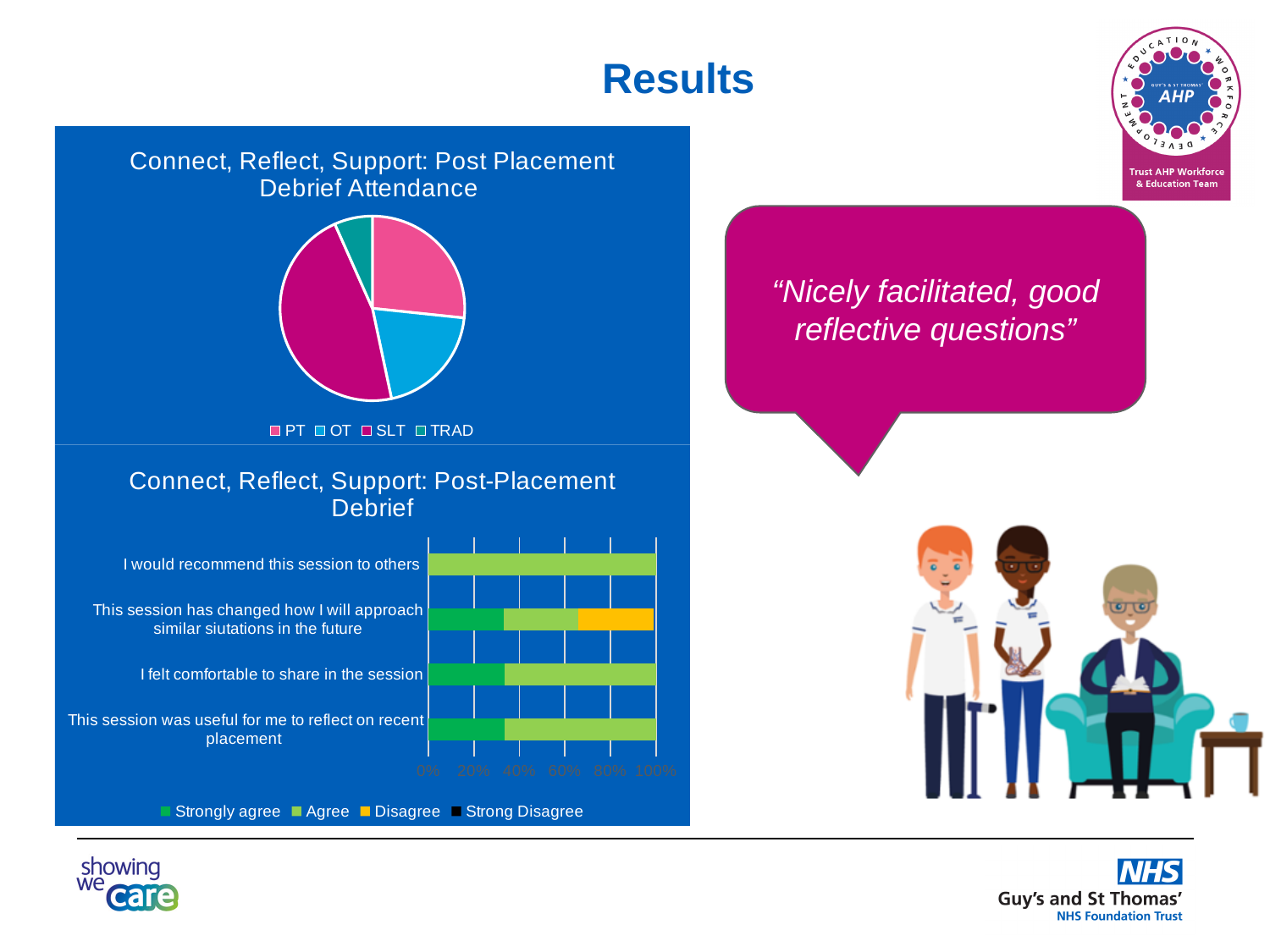
In the bottom bar chart, how many statements (categories) are plotted? 4 What kind of chart is the top chart titled 'Connect, Reflect, Support: Post Placement Debrief Attendance'? Pie chart In the bottom bar chart, how many series does the legend list? 4 In the top pie chart, which slice is larger, SLT or TRAD? SLT In the bottom bar chart, what percentage of responses for 'I would recommend this session to others' were Agree? 100% What kind of chart is the bottom chart titled 'Connect, Reflect, Support: Post-Placement Debrief'? Bar chart In the bottom bar chart, which statement has a Disagree segment? This session has changed how I will approach similar situations in the future In the top pie chart, which slice is larger, PT or OT? PT In the top pie chart, which category has the largest slice? SLT In the bottom bar chart, is the Strongly agree share for 'I felt comfortable to share in the session' greater or less than 40%? less In the top pie chart, which category has the smallest slice? TRAD In the top pie chart, how many categories does the legend list? 4